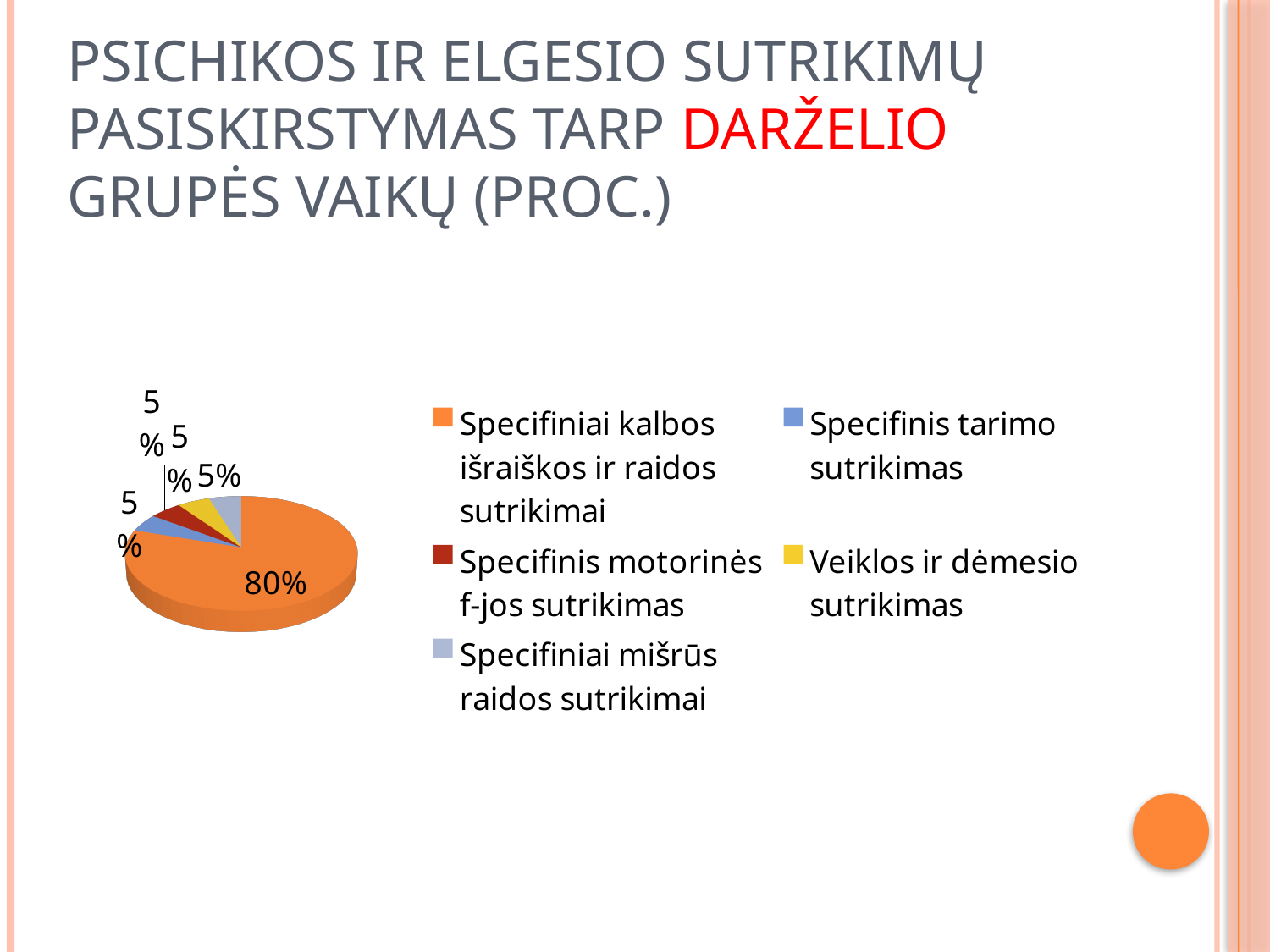
What is the difference in percentage points between 'Specifiniai kalbos išraiškos ir raidos sutrikimai' and 'Specifiniai mišrūs raidos sutrikimai'? 75 percentage points How many slices does the pie chart have? 5 How many categories does the legend list? 5 Which is larger: the slice for 'Specifiniai kalbos išraiškos ir raidos sutrikimai' or the slice for 'Specifinis tarimo sutrikimas'? Specifiniai kalbos išraiškos ir raidos sutrikimai Which category has the largest slice of the pie? Specifiniai kalbos išraiškos ir raidos sutrikimai How many categories in the pie chart each have a share of 5%? 4 What share of the pie does 'Specifinis motorinės f-jos sutrikimas' represent? 5% What share of the pie does 'Specifiniai kalbos išraiškos ir raidos sutrikimai' represent? 80% Which colour represents 'Veiklos ir dėmesio sutrikimas' in the legend? Yellow What share of the pie does 'Specifinis tarimo sutrikimas' represent? 5% What kind of chart is shown on the slide? Pie chart What share of the pie does 'Veiklos ir dėmesio sutrikimas' represent? 5%